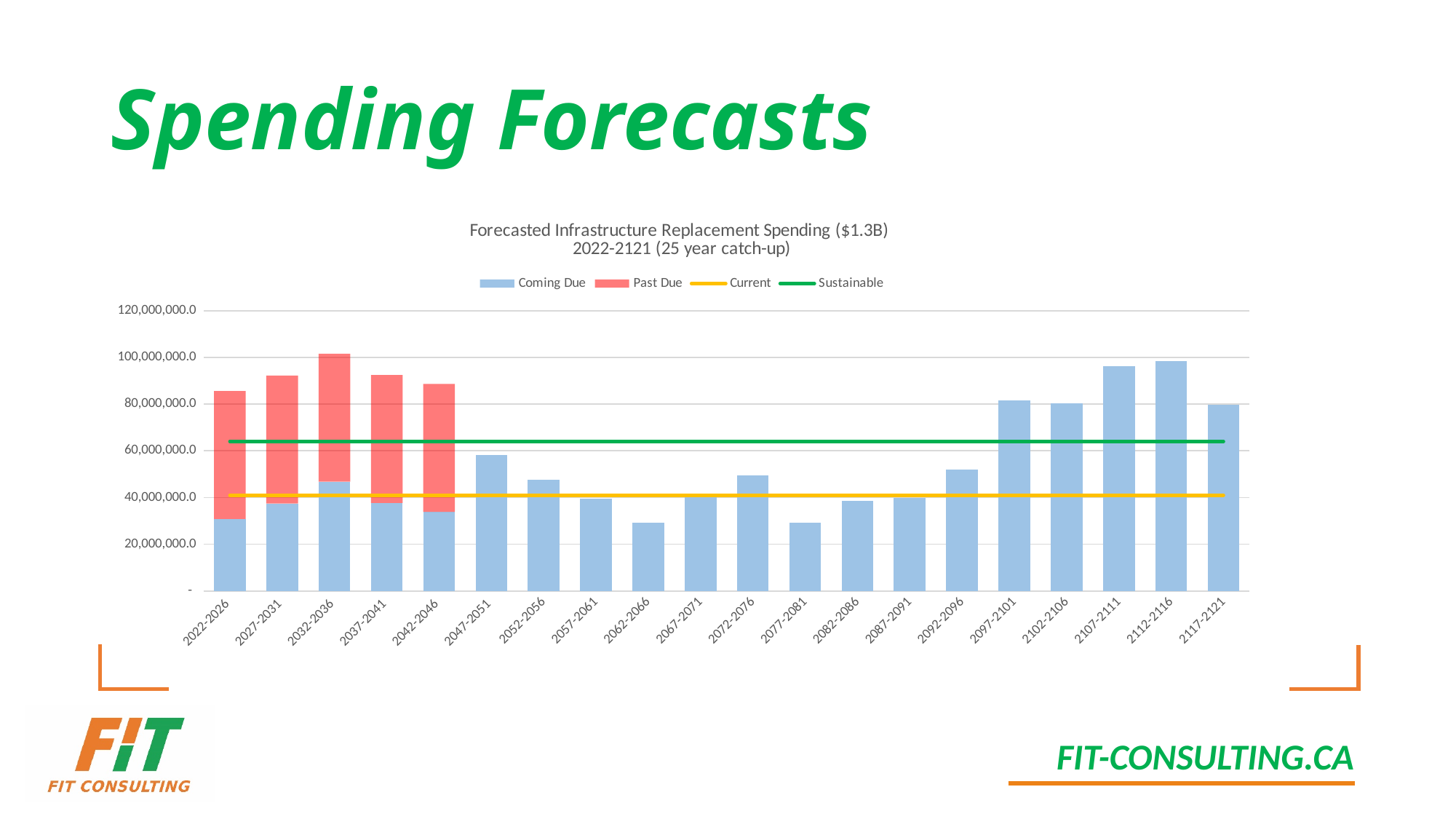
How many five-year periods are shown on the x axis of the chart? 20 What kind of chart is shown on the slide? Bar chart (stacked, with line series) How many periods include a Past Due (red) segment? 5 Which period has the tallest stacked bar in the chart? 2032-2036 Do the Coming Due bars rise or fall from 2097-2101 to 2112-2116? rise What are the four series named in the chart legend? Coming Due, Past Due, Current, Sustainable How many series does the chart legend list? 4 Is the Coming Due value for 2062-2066 greater or less than 40,000,000.0? less What is the title of the chart? Forecasted Infrastructure Replacement Spending ($1.3B) 2022-2121 (25 year catch-up) Is the Coming Due value for 2107-2111 greater or less than 80,000,000.0? greater Which has the larger Coming Due value, 2047-2051 or 2052-2056? 2047-2051